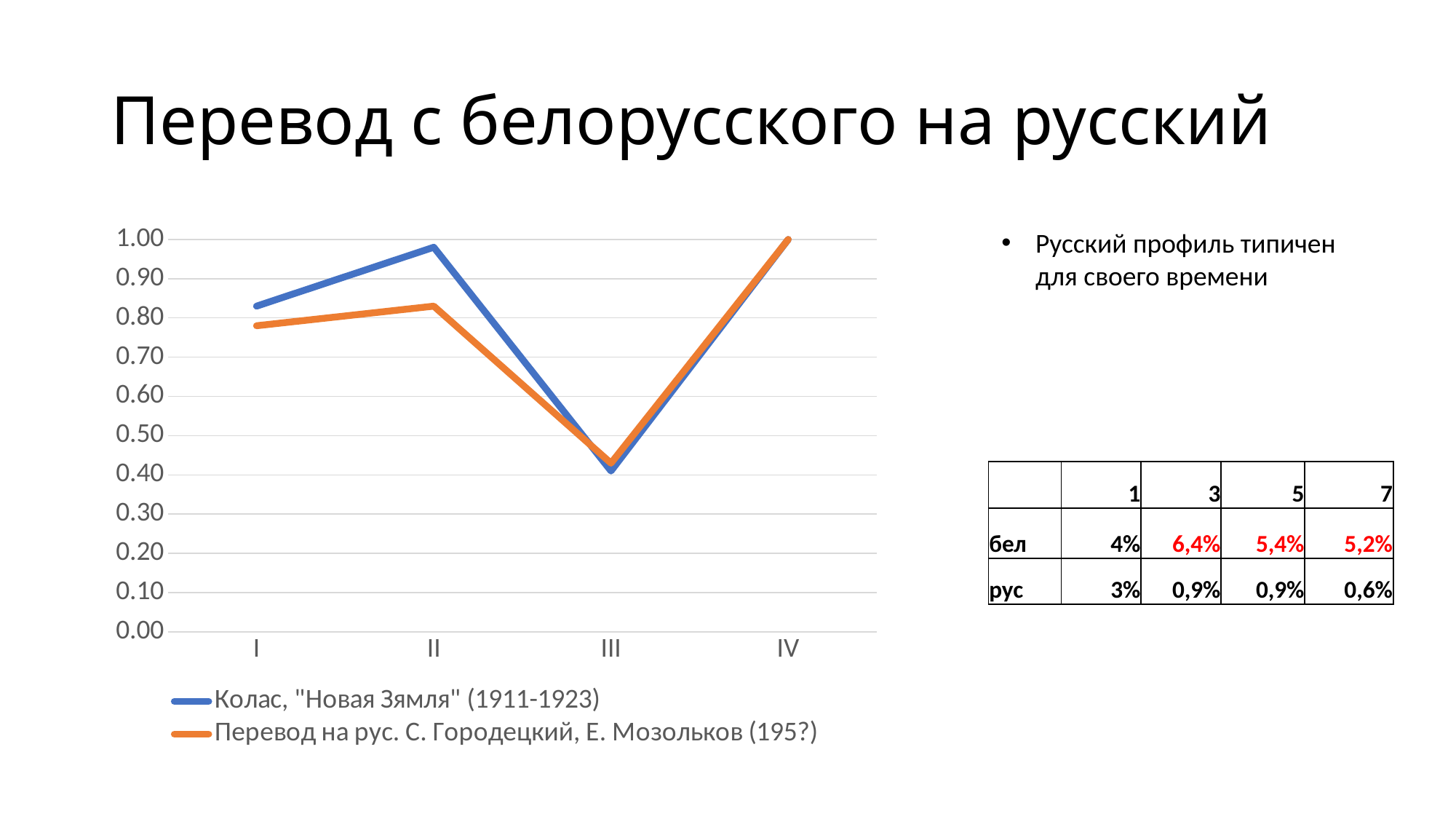
Is the value for Колас, "Новая Зямля" (1911-1923) at category II greater or less than 0.90? greater How many series does the chart legend list? 2 How many categories are shown on the x axis of the chart? 4 Is the value for Перевод на рус. С. Городецкий, Е. Мозольков (195?) at category I greater or less than 0.70? greater Which colour is used for the series Перевод на рус. С. Городецкий, Е. Мозольков (195?) in the chart? orange Does the series Колас, "Новая Зямля" (1911-1923) rise or fall from category II to category III? fall At which category does the series Колас, "Новая Зямля" (1911-1923) reach its lowest value? III At category II, which series has the larger value: Колас, "Новая Зямля" (1911-1923) or Перевод на рус. С. Городецкий, Е. Мозольков (195?)? Колас, "Новая Зямля" (1911-1923) At which category does the series Перевод на рус. С. Городецкий, Е. Мозольков (195?) reach its lowest value? III What kind of chart is shown on the slide? line chart Is the value for Колас, "Новая Зямля" (1911-1923) at category III greater or less than 0.50? less At which category does the series Перевод на рус. С. Городецкий, Е. Мозольков (195?) reach its highest value? IV